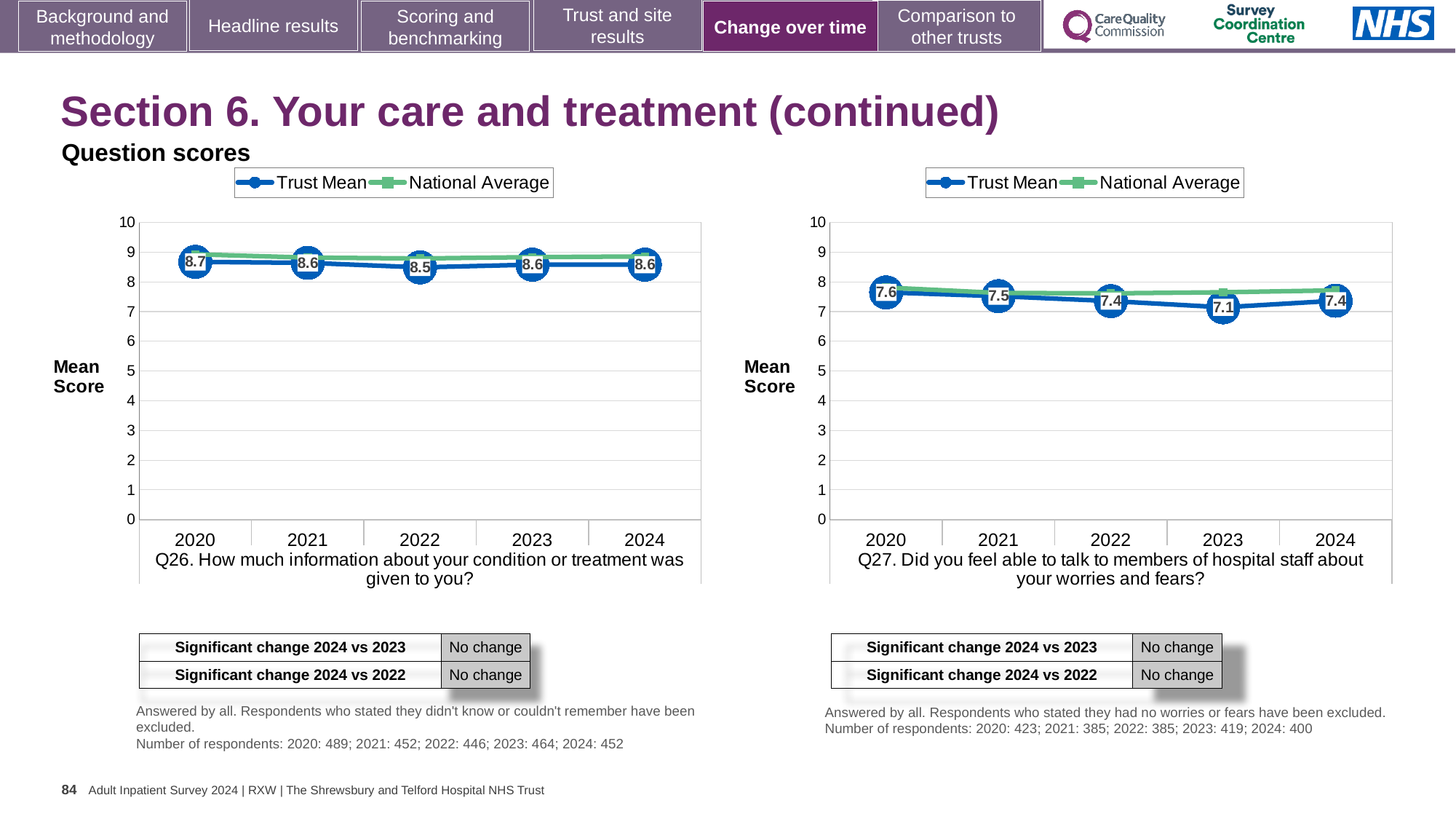
On the Q27 chart (right), what is the difference between the Trust Mean scores for 2020 and 2023? 0.5 How many series does the legend of the Q27 chart (right) list? 2 On the Q27 chart (right), what is the Trust Mean score for 2024? 7.4 On the Q27 chart (right), which year has the highest Trust Mean score? 2020 What type of chart is the Q26 chart (left)? Line chart How many years are plotted on the Q26 chart (left)? 5 On the Q27 chart (right), what is the Trust Mean score for 2023? 7.1 On the Q27 chart (right), which year has the lowest Trust Mean score? 2023 On the Q27 chart (right), is the Trust Mean score for 2021 greater or less than 7? greater On the Q26 chart (left), what is the difference between the Trust Mean scores for 2020 and 2022? 0.2 On the Q26 chart (left), what is the Trust Mean score for 2020? 8.7 On the Q26 chart (left), what is the Trust Mean score for 2022? 8.5